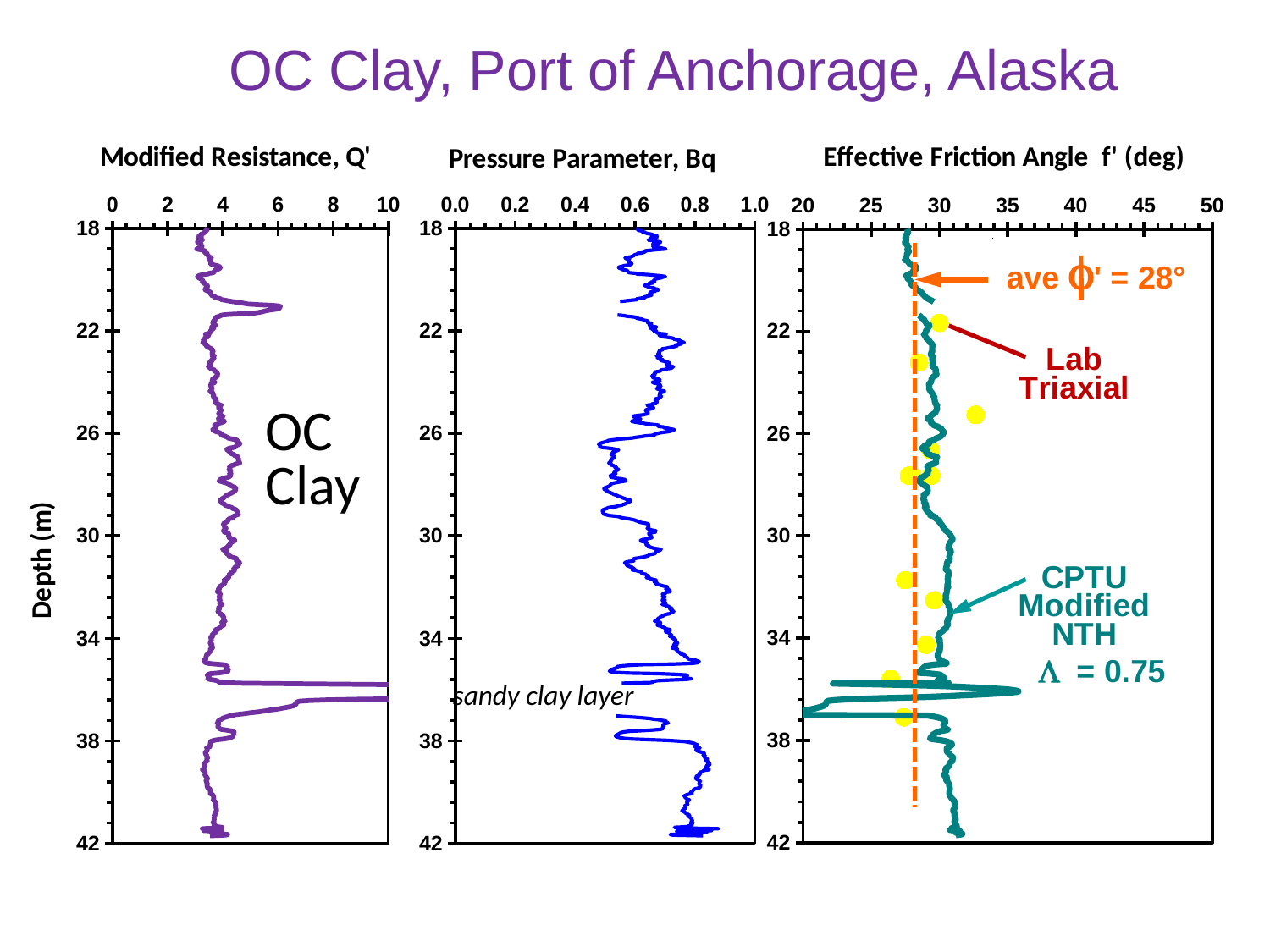
In the Effective Friction Angle chart, what average friction angle is annotated by the dashed line? 28° In the Pressure Parameter, Bq chart, is the value at a depth of 40 m greater or less than 0.6? greater What is the label on the vertical axis of the left-hand chart? Depth (m) In the Pressure Parameter, Bq chart, is the value at a depth of 22 m greater or less than 0.4? greater What kind of chart is the left-hand chart, Modified Resistance, Q'? line chart What is the title of the middle chart? Pressure Parameter, Bq What is the maximum depth shown on the vertical axis of the charts? 42 In the Effective Friction Angle chart, what value of Λ is printed for the CPTU Modified NTH curve? 0.75 In the Effective Friction Angle chart, is the CPTU curve value at a depth of 30 m greater or less than 35? less How many charts are shown on the slide? 3